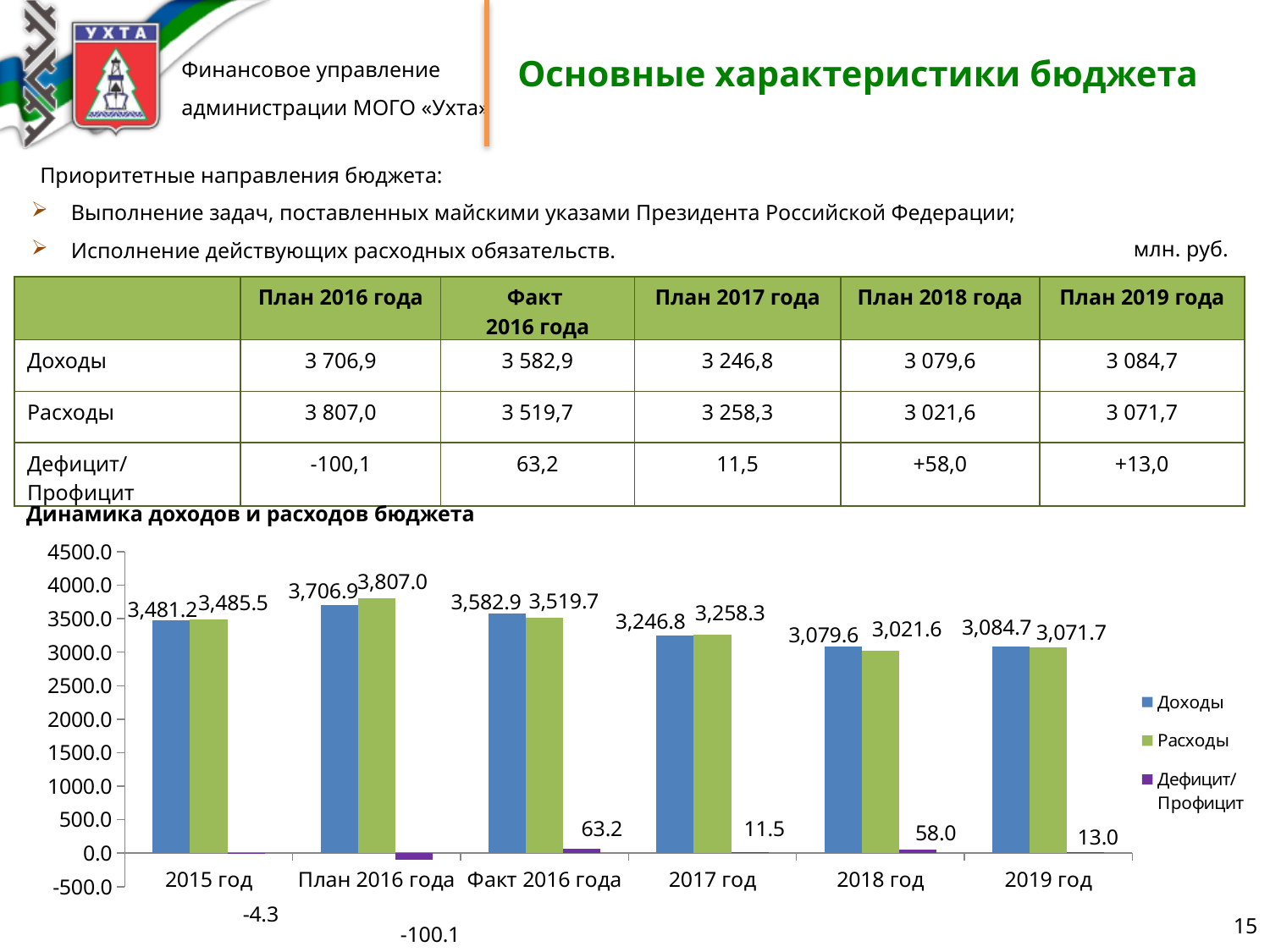
What is the value of Расходы for План 2016 года in the chart? 3,807.0 Which category has the lowest Доходы value in the chart? 2018 год What type of chart is shown under the heading 'Динамика доходов и расходов бюджета'? bar chart For 2018 год, which is larger in the chart: Доходы or Расходы? Доходы Is the Доходы value for 2017 год greater or less than 3500.0? less How many series does the legend of the chart list? 3 What is the value of Доходы for 2015 год in the chart? 3,481.2 How many categories are shown on the x axis of the chart? 6 Do the Доходы values rise or fall from Факт 2016 года to 2018 год in the chart? fall What is the value of Дефицит/Профицит for Факт 2016 года in the chart? 63.2 Which category has the highest Расходы value in the chart? План 2016 года What is the difference between Расходы and Доходы for План 2016 года in the chart? 100.1